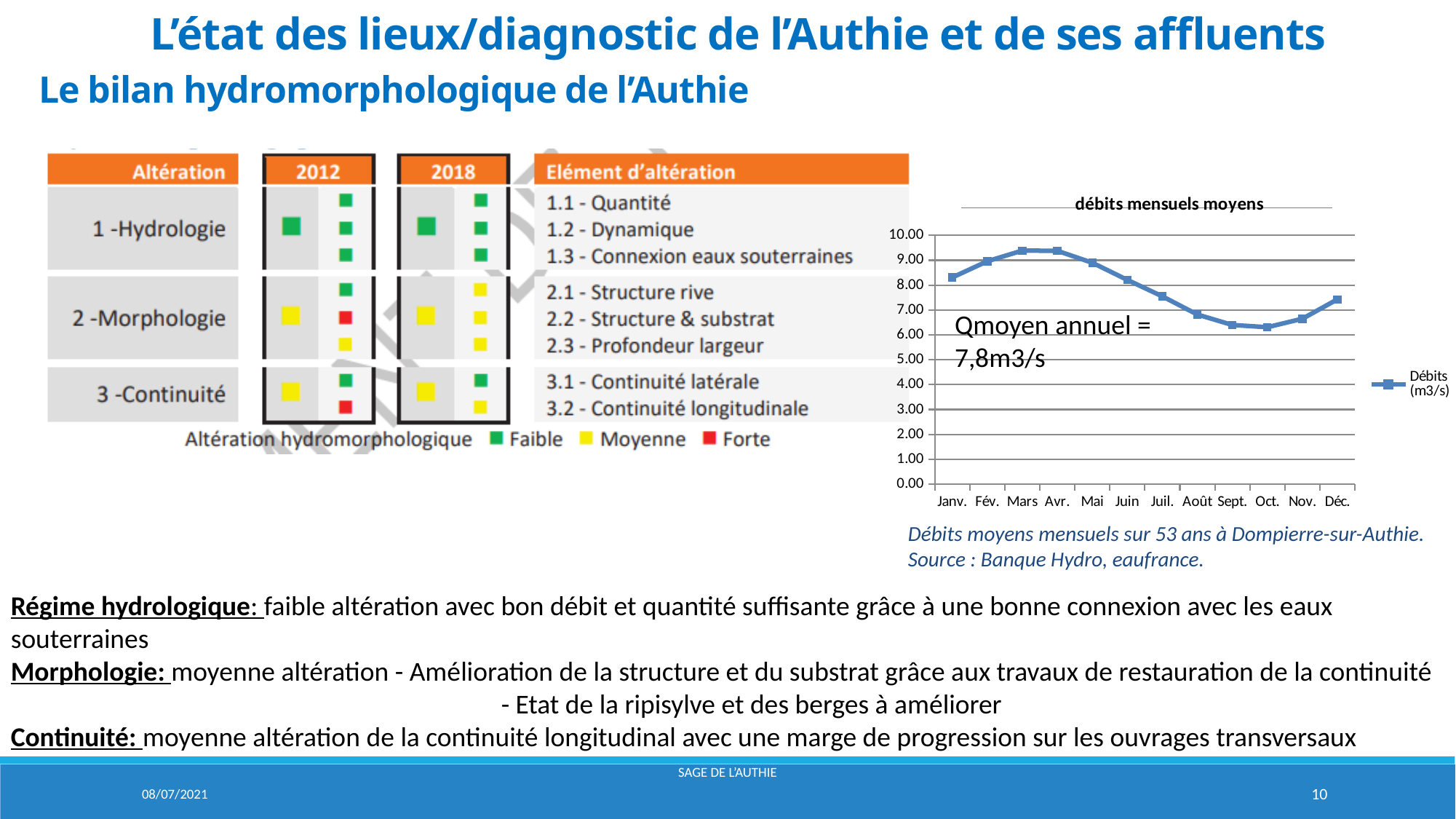
In the 'débits mensuels moyens' chart, which month has the larger value, Déc. or Avr.? Avr. In the 'débits mensuels moyens' chart, do the values rise or fall from Avr. to Oct.? fall What annual mean flow (Qmoyen annuel) is written on the 'débits mensuels moyens' chart? 7,8m3/s How many series does the legend of the 'débits mensuels moyens' chart list? 1 What kind of chart is the 'débits mensuels moyens' chart? line chart In the 'débits mensuels moyens' chart, is the value for Mars greater or less than 9.00? greater How many months are plotted on the x axis of the 'débits mensuels moyens' chart? 12 In the 'débits mensuels moyens' chart, is the value for Janv. greater or less than 8.00? greater In the 'débits mensuels moyens' chart, is the value for Sept. greater or less than 7.00? less What is the legend entry of the series in the 'débits mensuels moyens' chart? Débits (m3/s) In the 'débits mensuels moyens' chart, which month has the larger value, Janv. or Juil.? Janv.